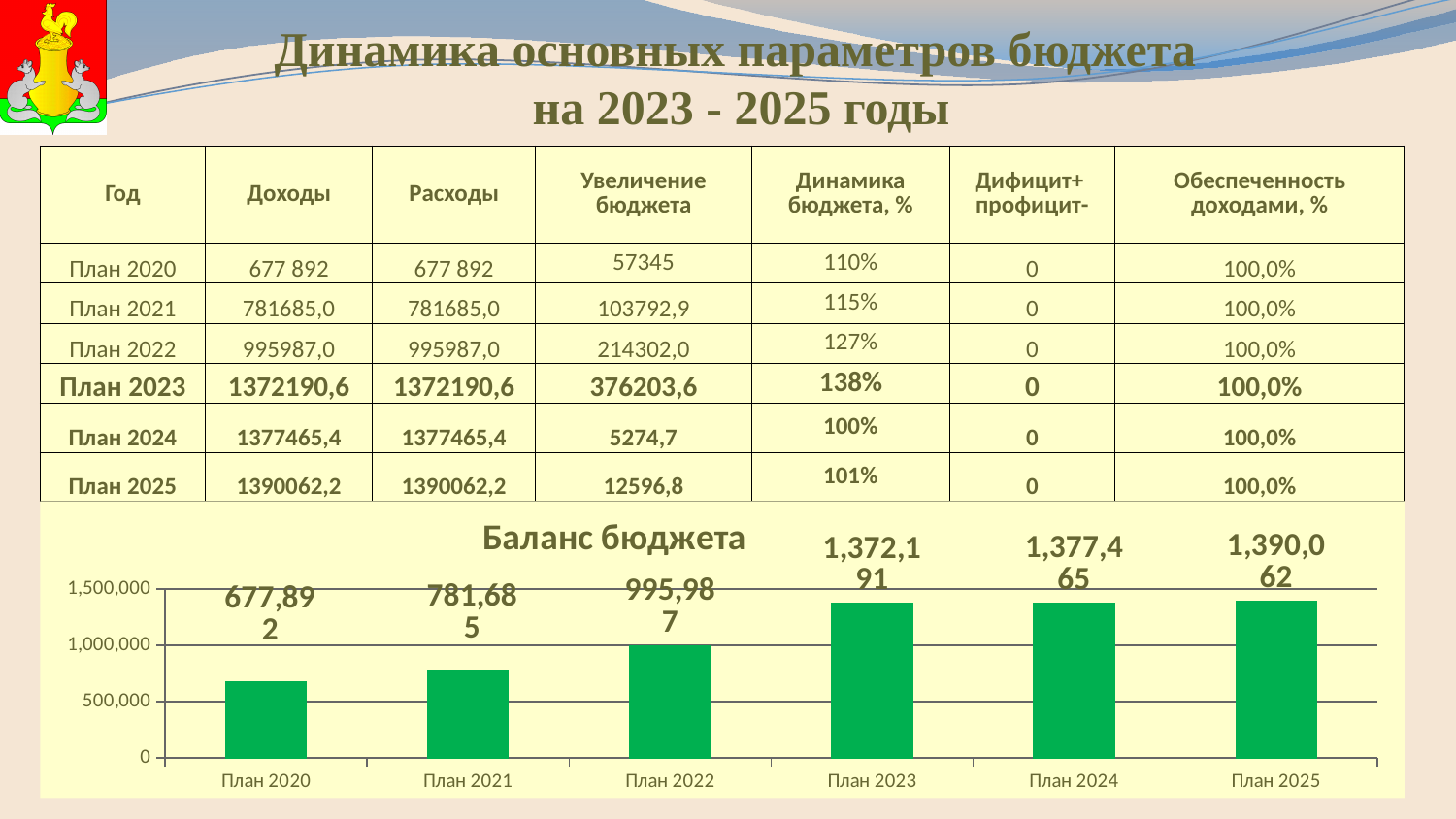
Do the values in the Баланс бюджета chart rise or fall from План 2020 to План 2025? rise Which is larger in the Баланс бюджета chart, the value for План 2022 or the value for План 2023? План 2023 What kind of chart is the Баланс бюджета chart? bar chart Which category has the lowest value in the Баланс бюджета chart? План 2020 Is the value for План 2022 in the Баланс бюджета chart greater or less than 1,000,000? less Which category has the highest value in the Баланс бюджета chart? План 2025 How many categories are shown on the x axis of the Баланс бюджета chart? 6 What is the value for План 2025 in the Баланс бюджета chart? 1,390,062 What is the value for План 2020 in the Баланс бюджета chart? 677,892 What is the difference between the values for План 2022 and План 2021 in the Баланс бюджета chart? 214,302 What is the difference between the values for План 2025 and План 2020 in the Баланс бюджета chart? 712,170 What is the value for План 2023 in the Баланс бюджета chart? 1,372,191